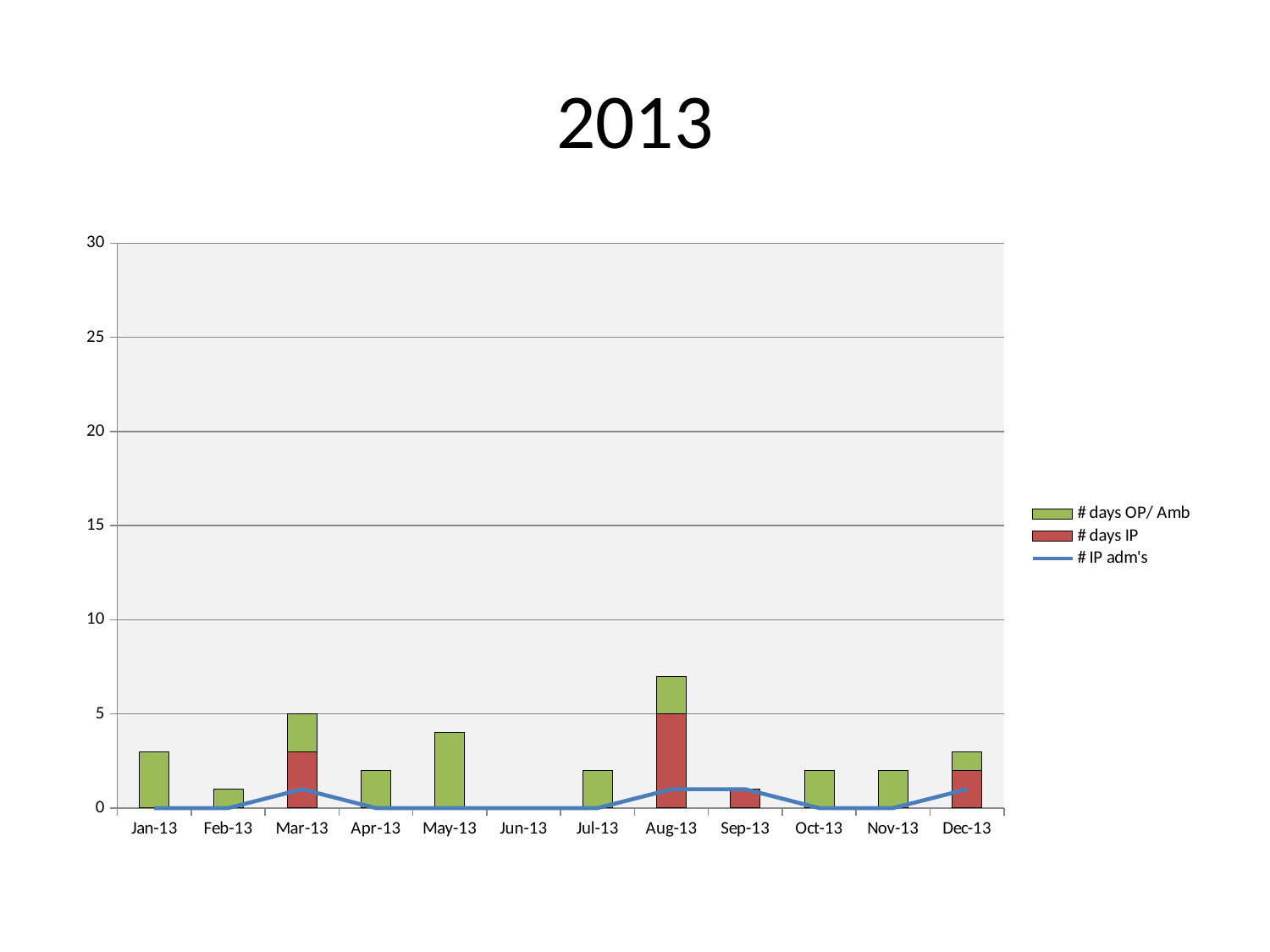
Which month has no bar at all? Jun-13 Which is taller, the stacked bar for Aug-13 or the stacked bar for Mar-13? Aug-13 What is the total height of the stacked bar for Mar-13? 5 How many months are shown along the x axis? 12 How many series does the legend list? 3 Is the total stacked bar for Aug-13 greater or less than 5? greater What kind of chart is shown on the slide? bar and line chart What is the title of the slide? 2013 What is the value of # IP adm's for Jan-13? 0 Which series is drawn as a line rather than bars? # IP adm's Which month has the tallest stacked bar? Aug-13 Is the total stacked bar for Jan-13 greater or less than 5? less